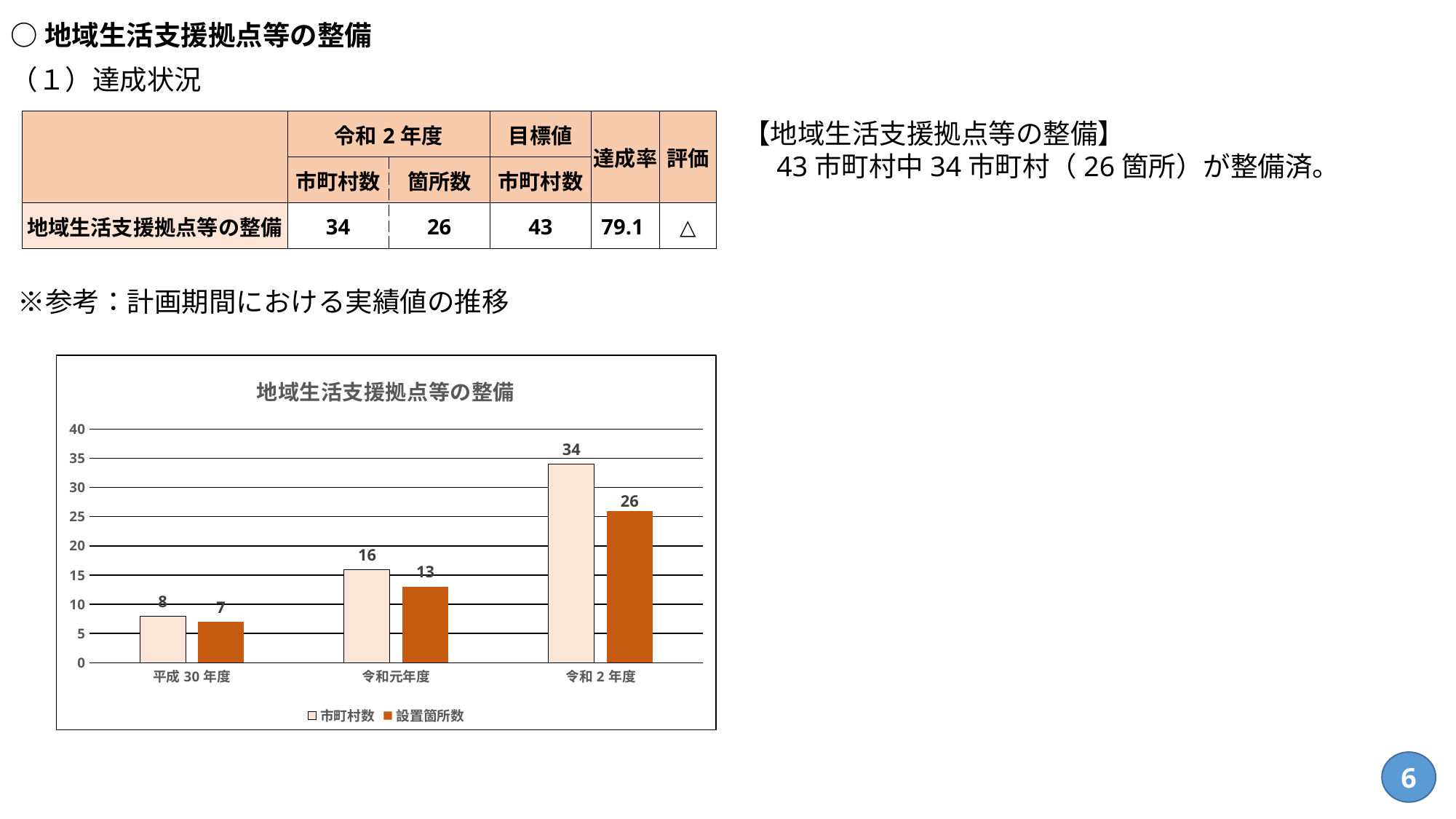
How many series does the chart legend list? 2 What is the value of 設置箇所数 for 平成30年度 in the chart? 7 Which year has the highest 市町村数 in the chart? 令和２年度 Which year has the lowest 設置箇所数 in the chart? 平成30年度 What is the difference between 市町村数 and 設置箇所数 for 令和２年度? 8 What is the value of 設置箇所数 for 令和元年度 in the chart? 13 How many year categories are shown on the x axis of the chart? 3 What is the value of 市町村数 for 令和２年度 in the chart? 34 Which is larger in 令和元年度: 市町村数 or 設置箇所数? 市町村数 How much did 市町村数 increase from 令和元年度 to 令和２年度? 18 Do the 市町村数 values rise or fall from 平成30年度 to 令和２年度? Rise What kind of chart is shown on the slide? Bar chart